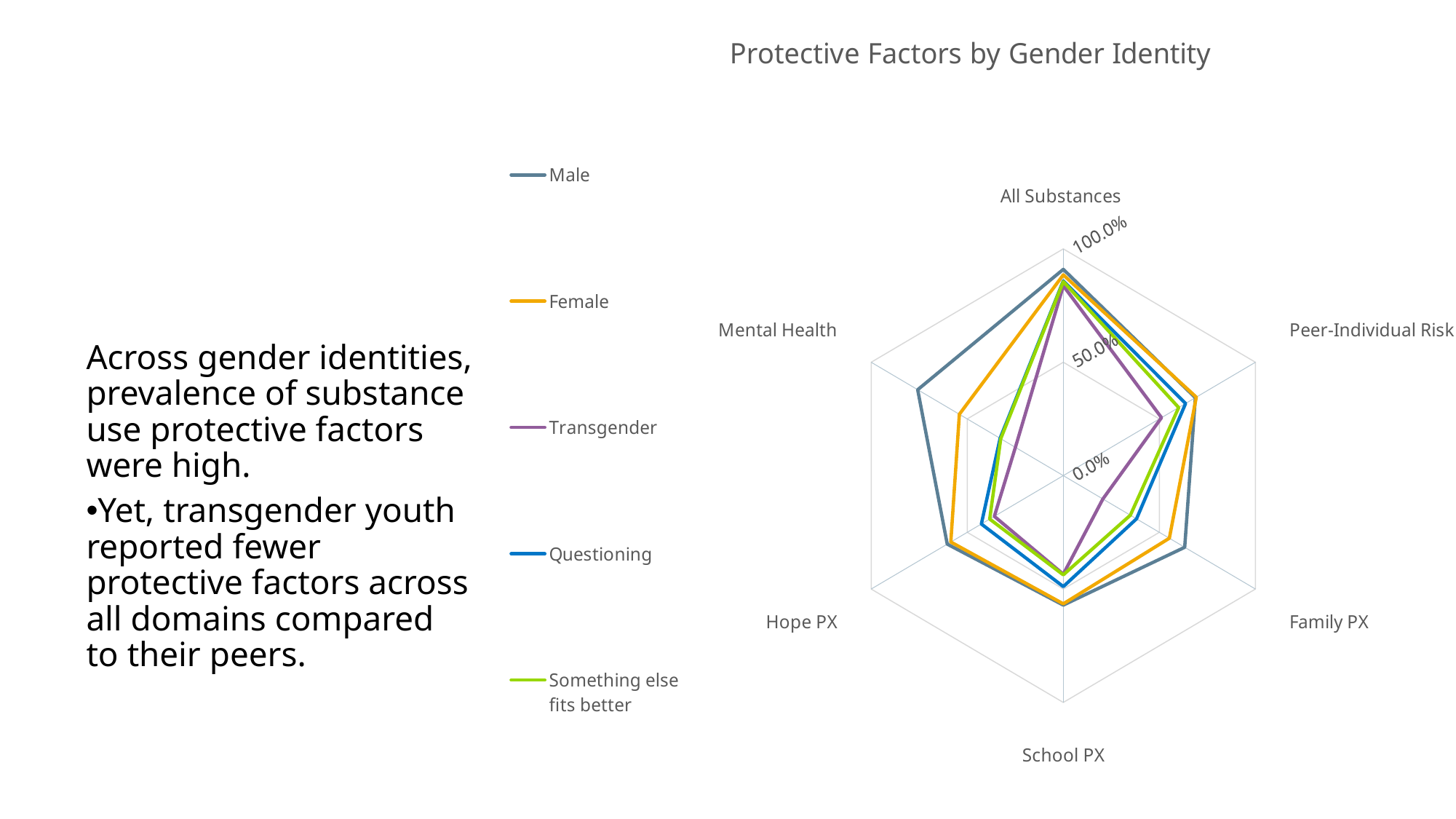
How many axes (categories) does the radar chart have? 6 How many series does the legend list? 5 Which series is drawn in purple? Transgender Is the Male value for All Substances greater or less than 50.0%? greater Is the Transgender value for Hope PX greater or less than 50.0%? less Which series has the lowest value for Mental Health? Transgender Which series has the highest value for Mental Health? Male Is the Male value for Mental Health greater or less than 50.0%? greater What kind of chart is shown on the slide? Radar chart Which is larger for Hope PX, the Female value or the Transgender value? Female What is the title of the chart? Protective Factors by Gender Identity